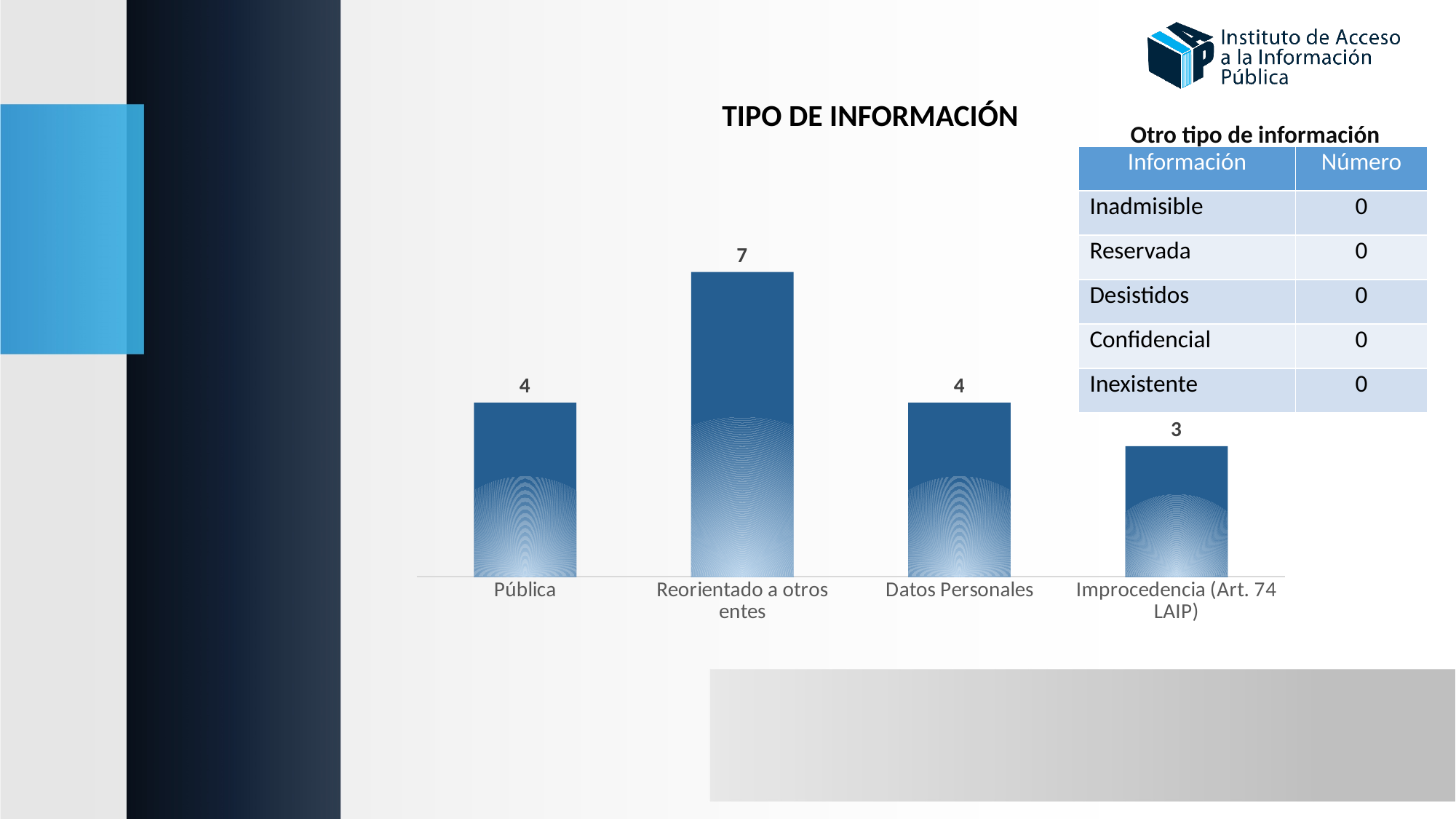
What is the value for Improcedencia (Art. 74 LAIP)? 3 What is the value for Pública? 4 What is the difference between the values for Reorientado a otros entes and Pública? 3 How many categories are shown in the chart? 4 Which category has the lowest value? Improcedencia (Art. 74 LAIP) What is the difference between the values for Datos Personales and Improcedencia (Art. 74 LAIP)? 1 What is the title of the chart? TIPO DE INFORMACIÓN What kind of chart is shown on the slide? bar chart Which category has the highest value? Reorientado a otros entes What is the value for Reorientado a otros entes? 7 Which is larger, the value for Reorientado a otros entes or the value for Datos Personales? Reorientado a otros entes What is the value for Datos Personales? 4